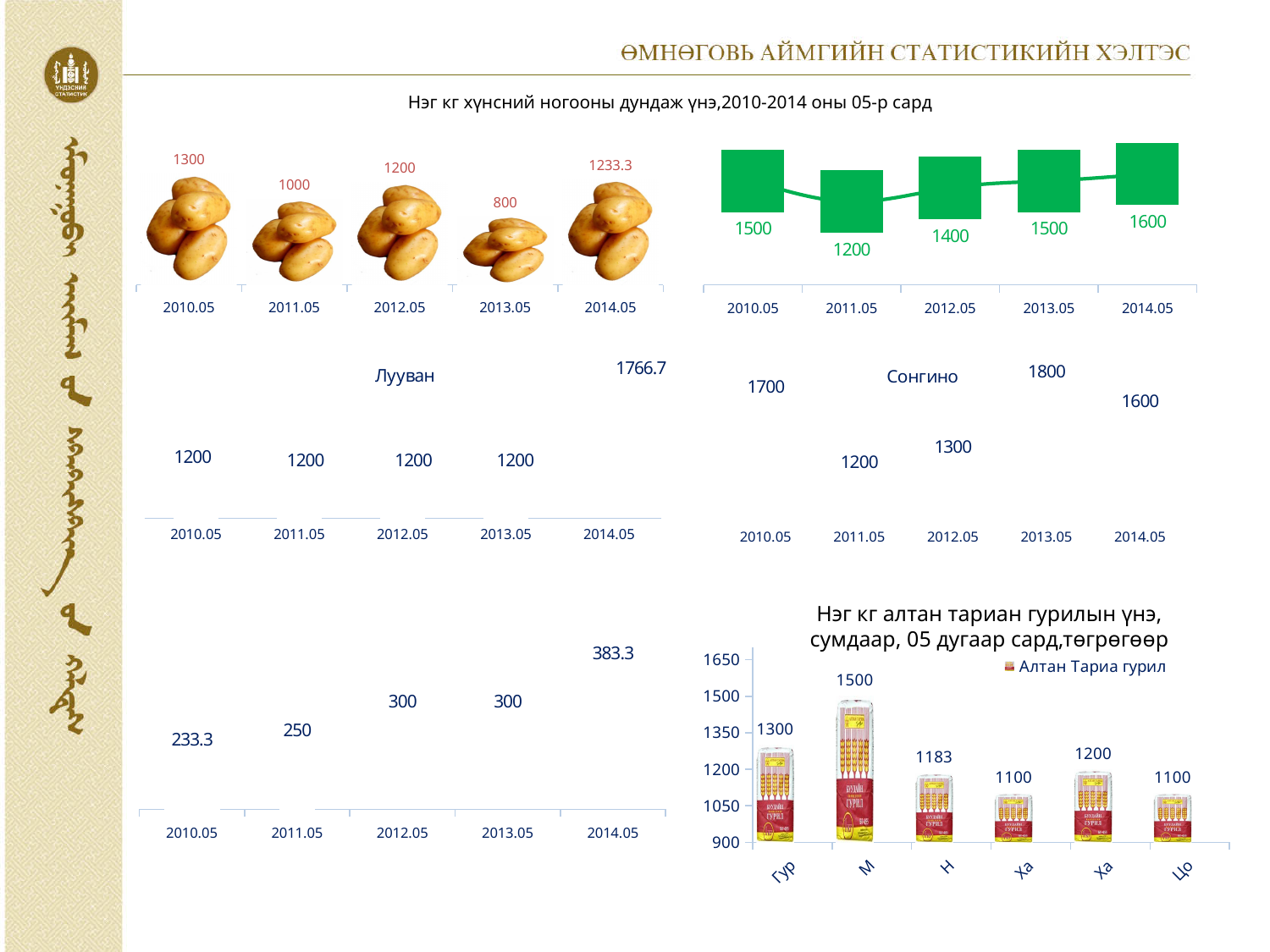
In the bottom-left chart, is the value for 2011.05 or 2014.05 larger? 2014.05 In the top-left potato chart, which period has the highest value? 2010.05 In the top-left potato chart, what is the value for 2013.05? 800 In the chart titled 'Нэг кг алтан тариан гурилын үнэ, сумдаар, 05 дугаар сард,төгрөгөөр', what is the value for the category М? 1500 In the Лууван chart, how many periods are shown on the x axis? 5 In the Сонгино chart, which period has the highest value? 2013.05 In the Сонгино chart, what is the difference between the 2013.05 and 2011.05 values? 600 In the top-left potato chart, what is the difference between the 2010.05 and 2013.05 values? 500 In the top-right green bar chart, what is the value for 2014.05? 1600 In the chart titled 'Нэг кг алтан тариан гурилын үнэ, сумдаар, 05 дугаар сард,төгрөгөөр', what series name does the legend show? Алтан Тариа гурил In the top-right green bar chart, which period has the lowest value? 2011.05 In the Лууван chart, what is the value for 2014.05? 1766.7